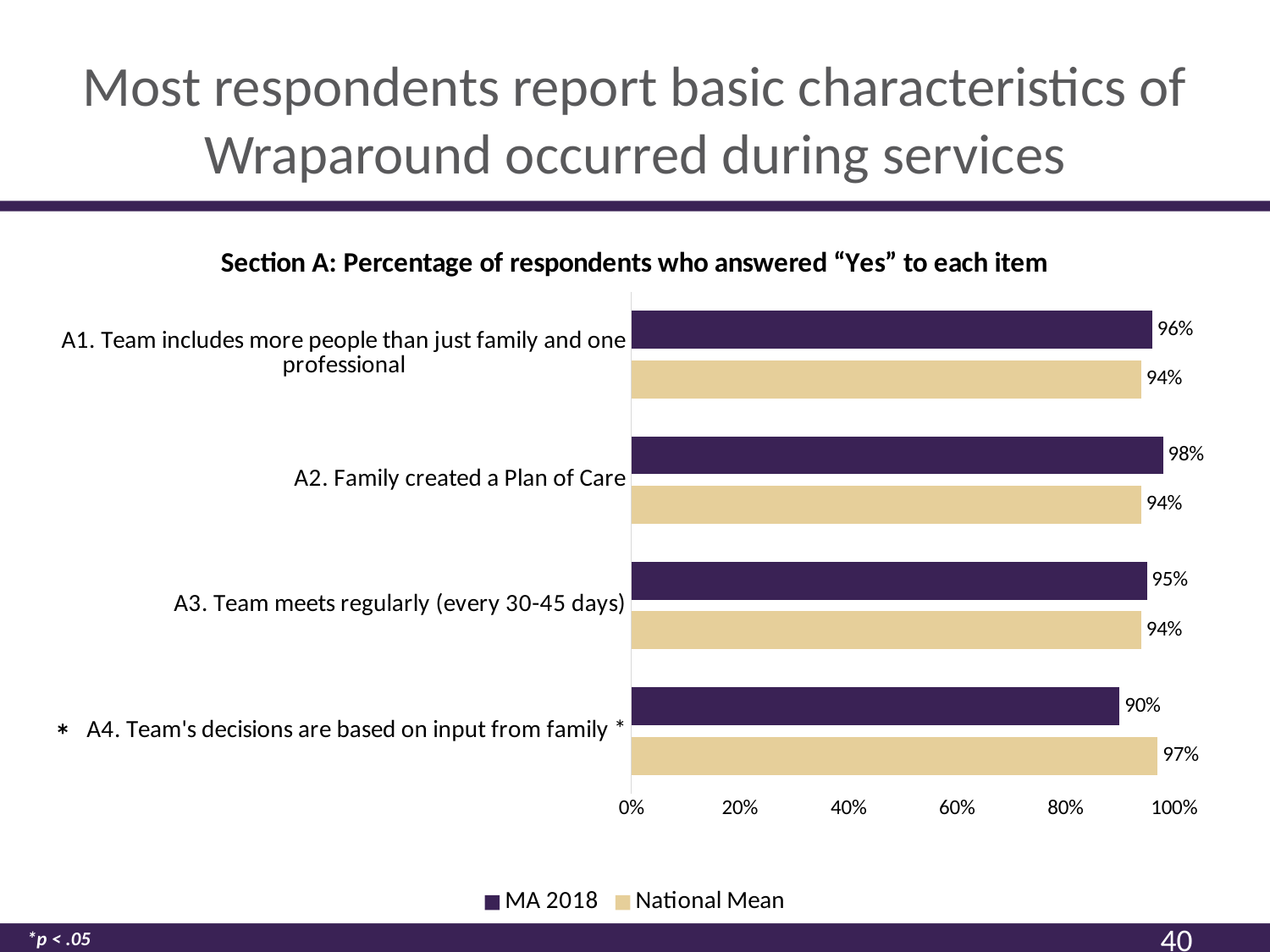
Which item has the lowest MA 2018 value? A4. Team's decisions are based on input from family For A1. Team includes more people than just family and one professional, which is larger: MA 2018 or National Mean? MA 2018 What kind of chart is shown on the slide? bar chart What is the difference between the MA 2018 and National Mean values for A4. Team's decisions are based on input from family? 7% How many series does the legend list? 2 How many items are shown on the chart? 4 What is the National Mean value for A4. Team's decisions are based on input from family? 97% Is the MA 2018 value for A4. Team's decisions are based on input from family greater or less than 80%? greater What is the MA 2018 value for A3. Team meets regularly (every 30-45 days)? 95% What is the MA 2018 value for A2. Family created a Plan of Care? 98% Which item has the highest MA 2018 value? A2. Family created a Plan of Care What is the title of the chart? Section A: Percentage of respondents who answered "Yes" to each item